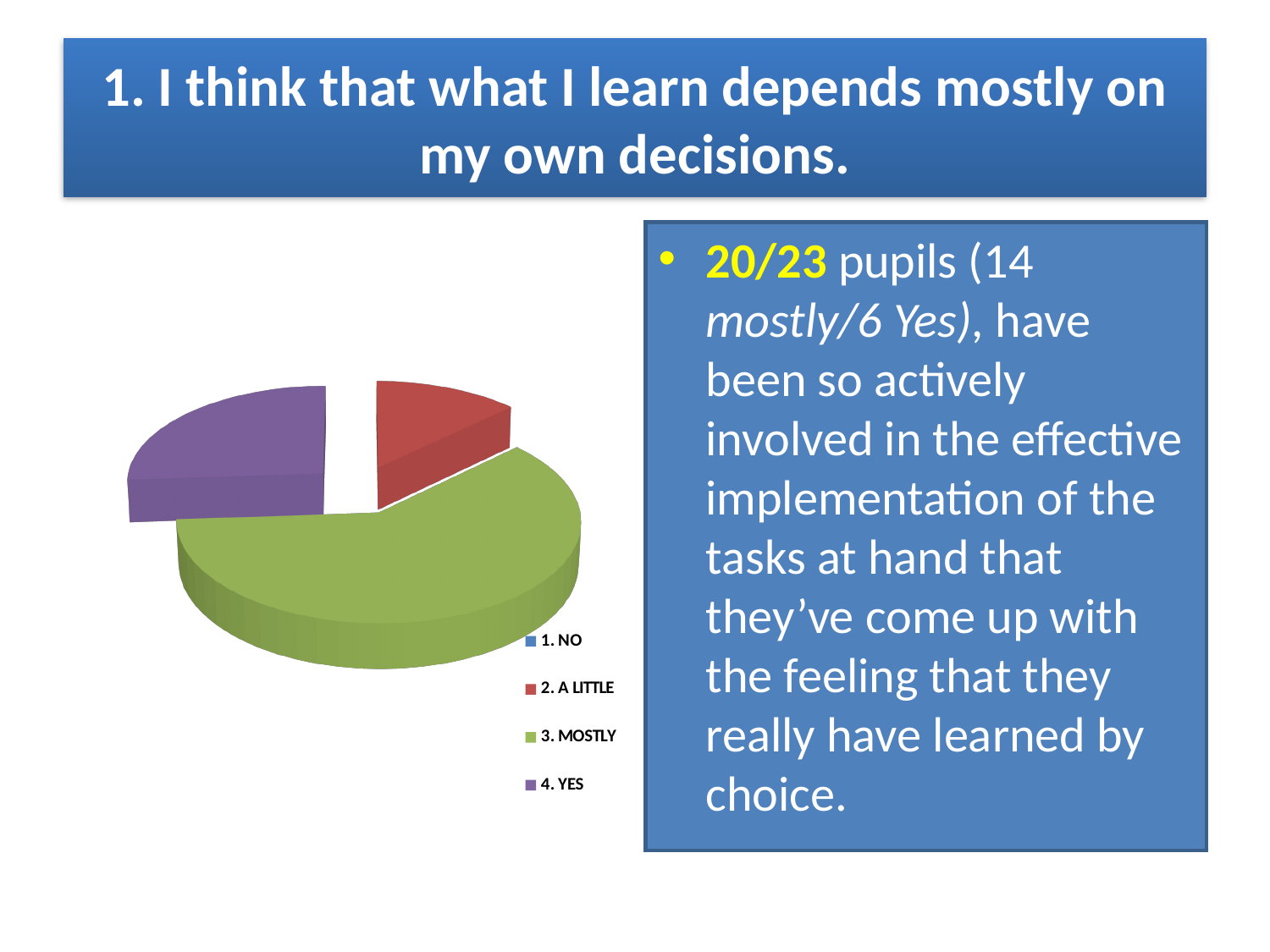
Which slice is larger, 2. A LITTLE or 4. YES? 4. YES What kind of chart is shown on the slide? pie chart How many categories does the legend of the pie chart list? 4 What colour is the 4. YES slice in the pie chart? purple Which slice is larger, 3. MOSTLY or 4. YES? 3. MOSTLY According to the slide, how many pupils answered MOSTLY? 14 Which category has the largest slice of the pie chart? 3. MOSTLY According to the slide, how many pupils answered YES? 6 What colour is the 3. MOSTLY slice in the pie chart? green